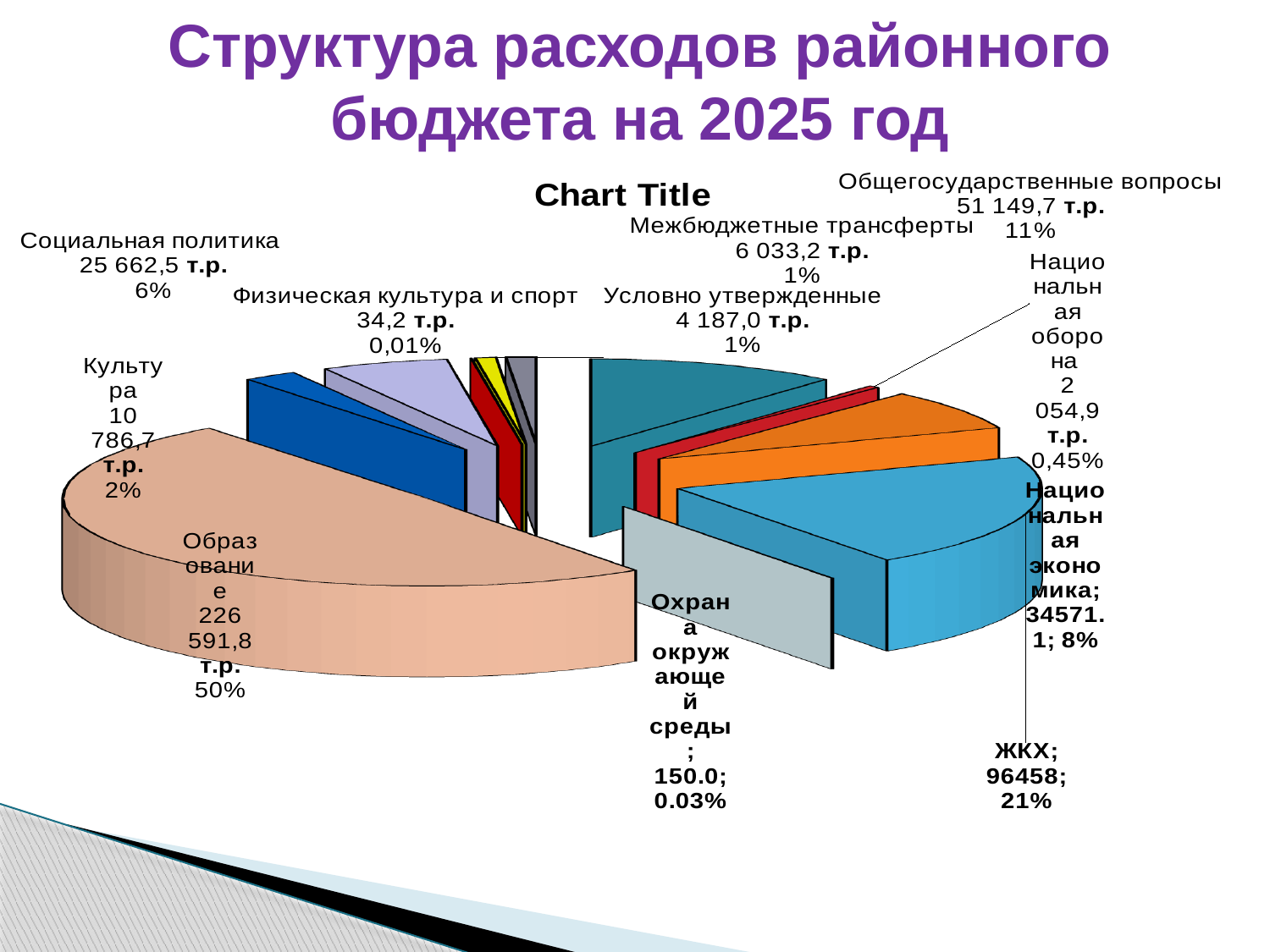
Which is larger, the share for ЖКХ or the share for Общегосударственные вопросы? ЖКХ What kind of chart is shown on the slide? pie chart Which category has the largest share of the pie? Образование What percentage share does ЖКХ have? 21% What is the value shown for Национальная экономика? 34571.1 What is the value shown for Образование? 226 591,8 т.р. What is the value shown for Общегосударственные вопросы? 51 149,7 т.р. What percentage share does Национальная оборона have? 0,45% What is the title printed above the pie chart? Chart Title What percentage share does Социальная политика have? 6% Which category has the smallest share of the pie? Физическая культура и спорт How many categories (slices) does the pie chart show? 11